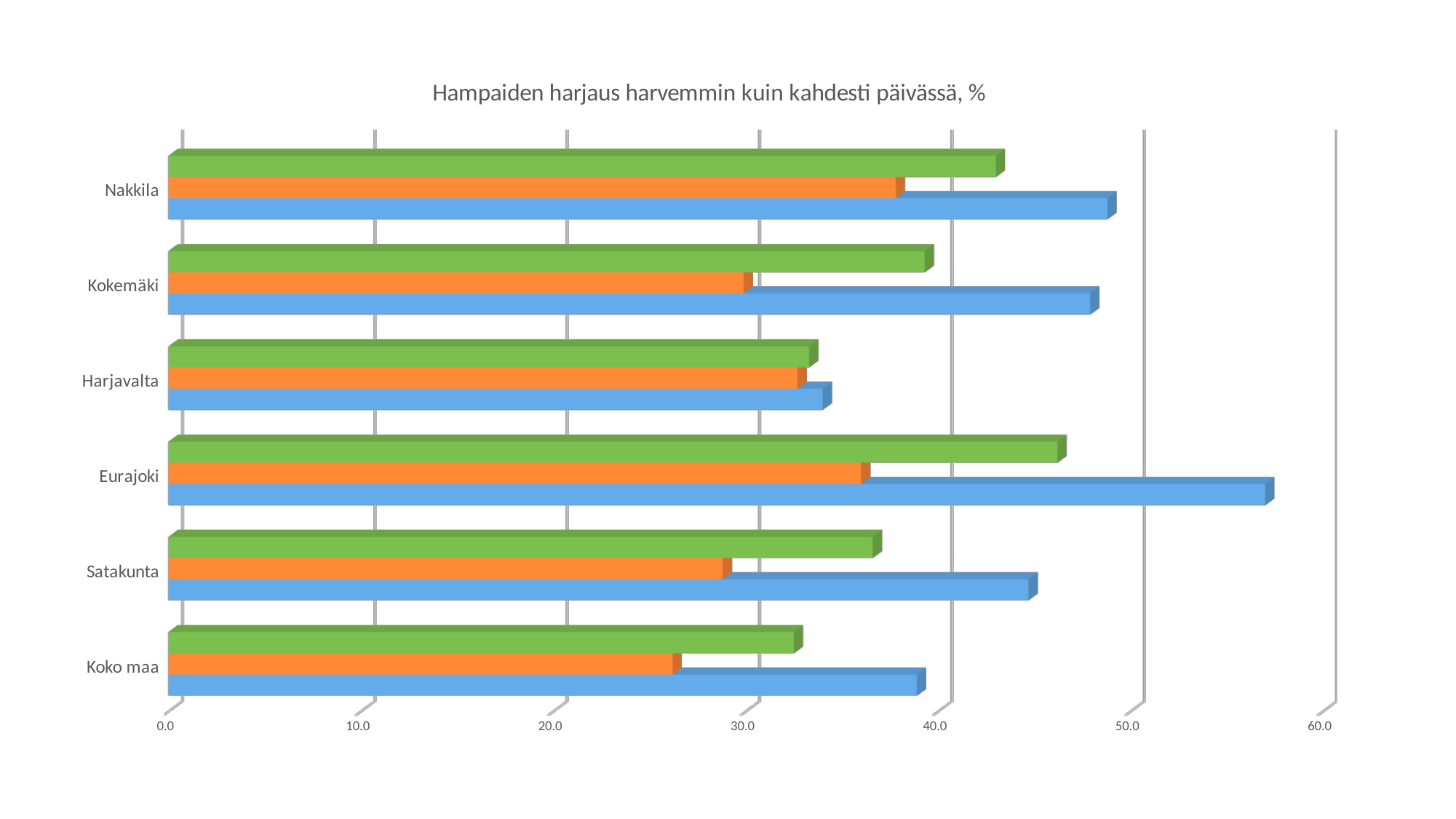
Is the value of the blue bar for Eurajoki greater or less than 50.0? greater Which category has the shortest orange bar? Koko maa Is the value of the green bar for Nakkila greater or less than 40.0? greater What kind of chart is shown on the slide? bar chart Which category has the longest blue bar? Eurajoki Is the value of the orange bar for Koko maa greater or less than 30.0? less Which category has the shortest blue bar? Harjavalta Which is larger, the blue bar for Eurajoki or the blue bar for Nakkila? Eurajoki How many bars (series) are plotted for each category in the chart? 3 How many categories are shown on the vertical axis of the chart? 6 Which category has the longest orange bar? Nakkila What is the title of the chart? Hampaiden harjaus harvemmin kuin kahdesti päivässä, %